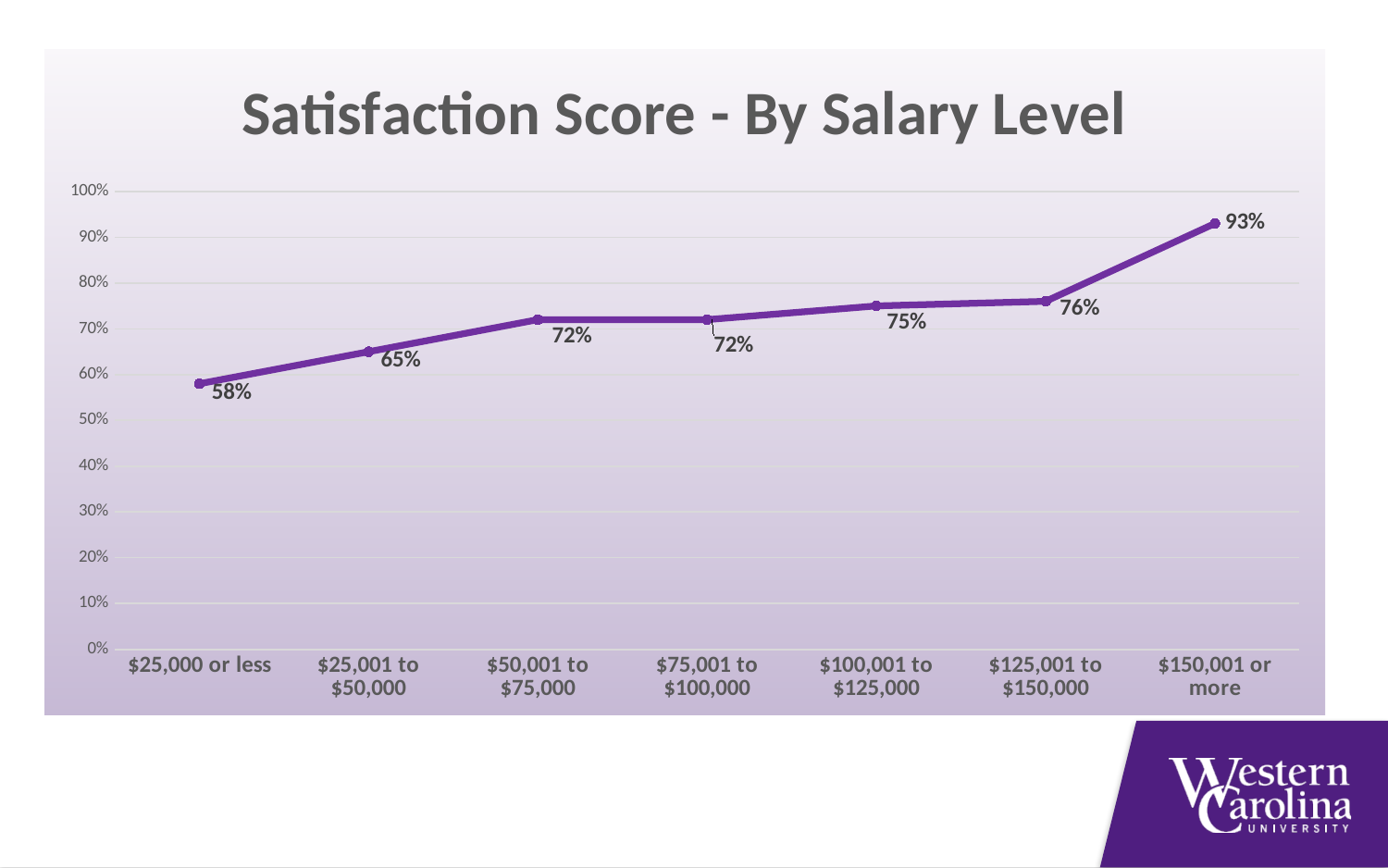
Which salary level has the lowest satisfaction score? $25,000 or less Is the satisfaction score for $50,001 to $75,000 greater or less than 70%? greater How many salary levels are shown on the chart? 7 What is the difference between the satisfaction scores for $150,001 or more and $125,001 to $150,000? 17% What is the satisfaction score for the $100,001 to $125,000 salary level? 75% Which has a higher satisfaction score: $25,001 to $50,000 or $100,001 to $125,000? $100,001 to $125,000 What is the satisfaction score for the $25,000 or less salary level? 58% Do satisfaction scores generally rise or fall as salary level increases? Rise Which salary level has the highest satisfaction score? $150,001 or more What kind of chart is shown on the slide? Line chart What is the satisfaction score for the $150,001 or more salary level? 93% What is the difference between the satisfaction scores for $25,001 to $50,000 and $25,000 or less? 7%